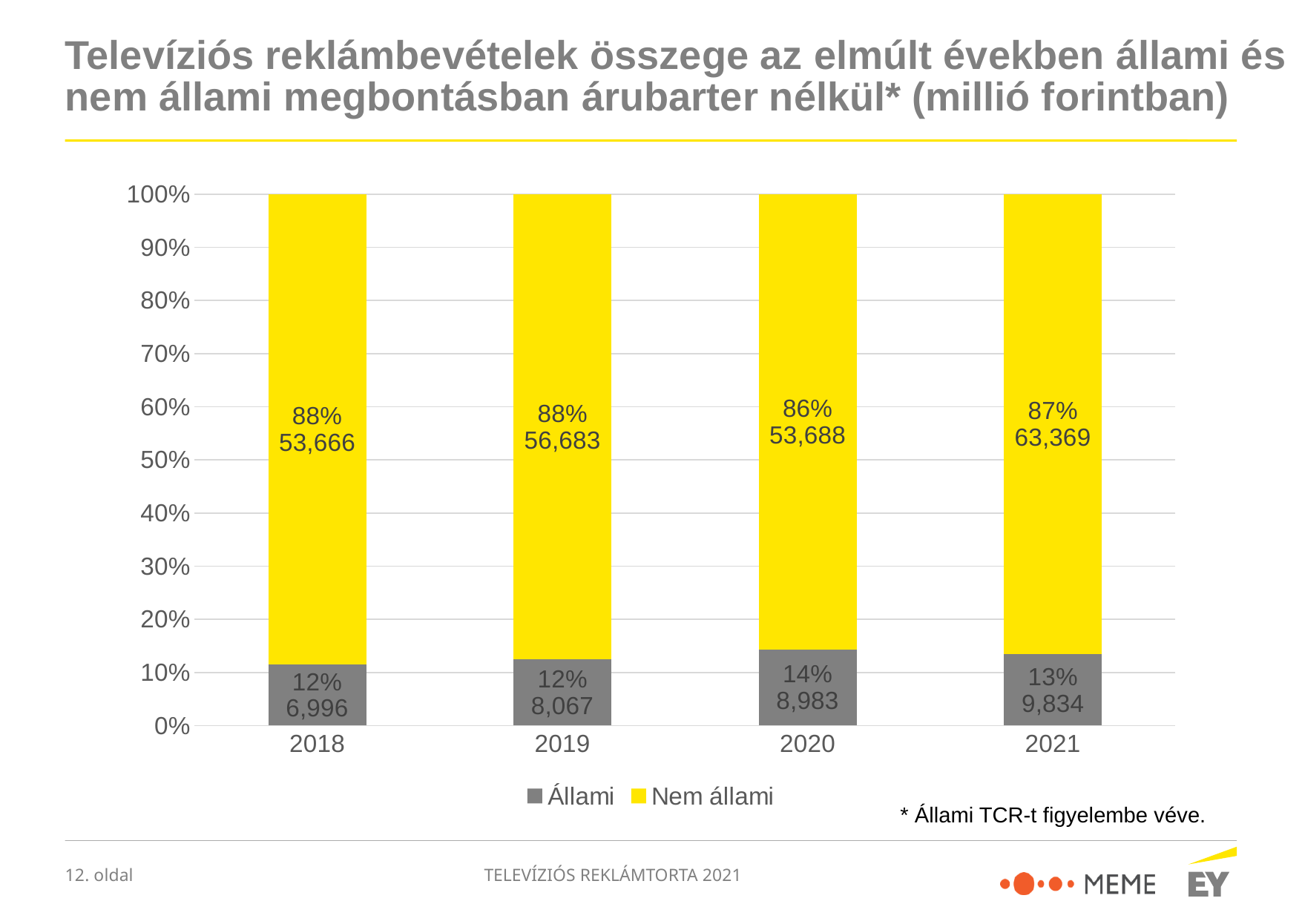
How many series does the legend list? 2 What is the total of the Állami and Nem állami values for 2018? 60,662 What percentage share does Állami have in 2020? 14% What is the difference between the Nem állami values for 2021 and 2020? 9,681 Which colour represents the Nem állami series? Yellow Which is larger, the Állami value for 2019 or for 2020? 2020 How many years are shown on the x axis? 4 What is the Állami value for 2021? 9,834 Which year has the lowest Állami value? 2018 What is the Nem állami value for 2019? 56,683 What kind of chart is shown on the slide? Stacked bar chart Which year has the highest Nem állami value? 2021